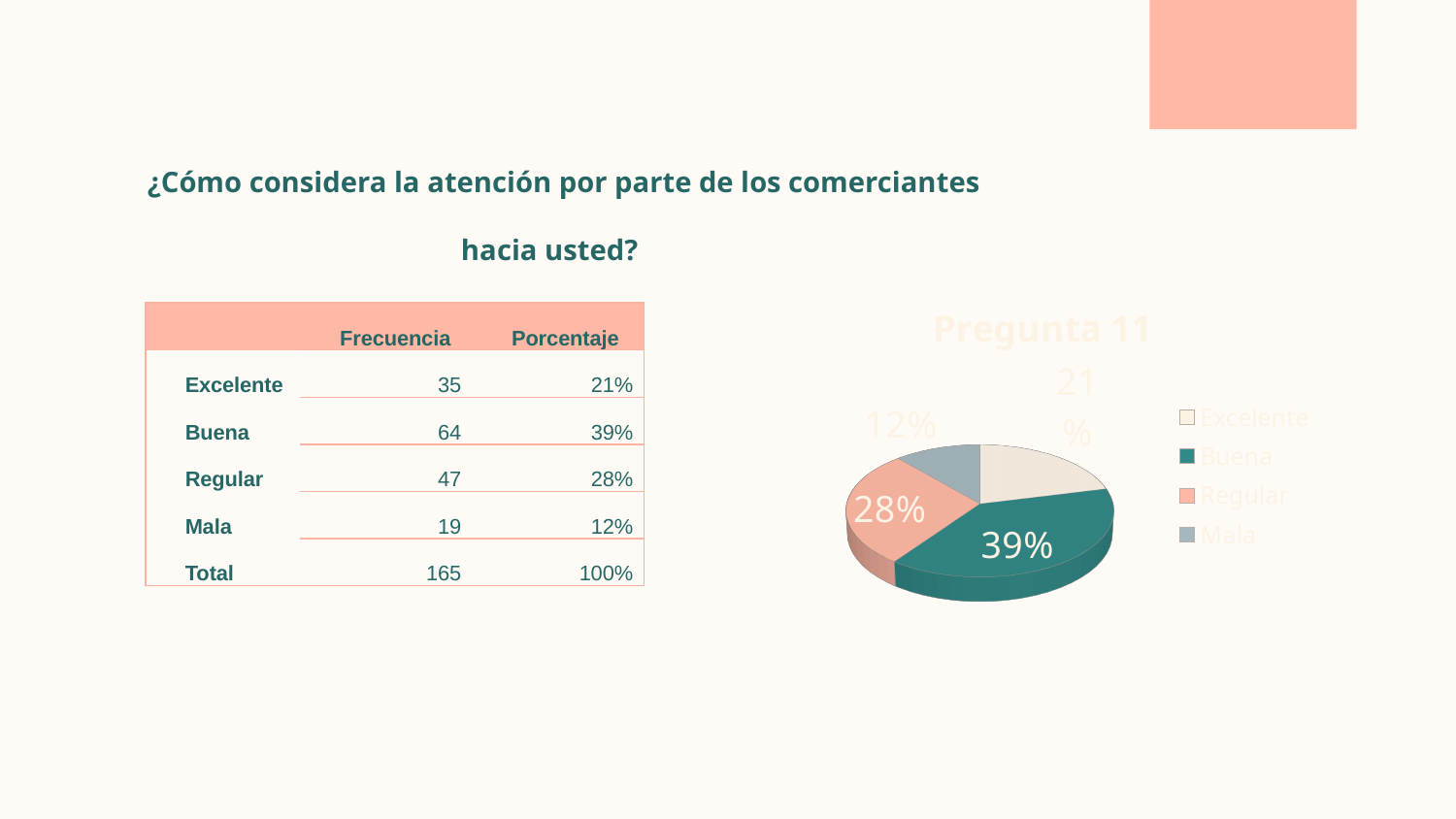
What share of the pie does the Buena slice represent? 39% What is the difference in percentage points between the Buena slice and the Mala slice? 27 How many categories does the pie chart's legend list? 4 What share of the pie does the Mala slice represent? 12% Which category has the smallest slice in the pie chart? Mala What kind of chart is shown on the slide? pie chart What is the title of the pie chart? Pregunta 11 What share of the pie does the Excelente slice represent? 21% Which legend entry is shown in the darkest teal colour in the pie chart? Buena Which category has the largest slice in the pie chart? Buena Which slice is larger in the pie chart, Regular or Excelente? Regular